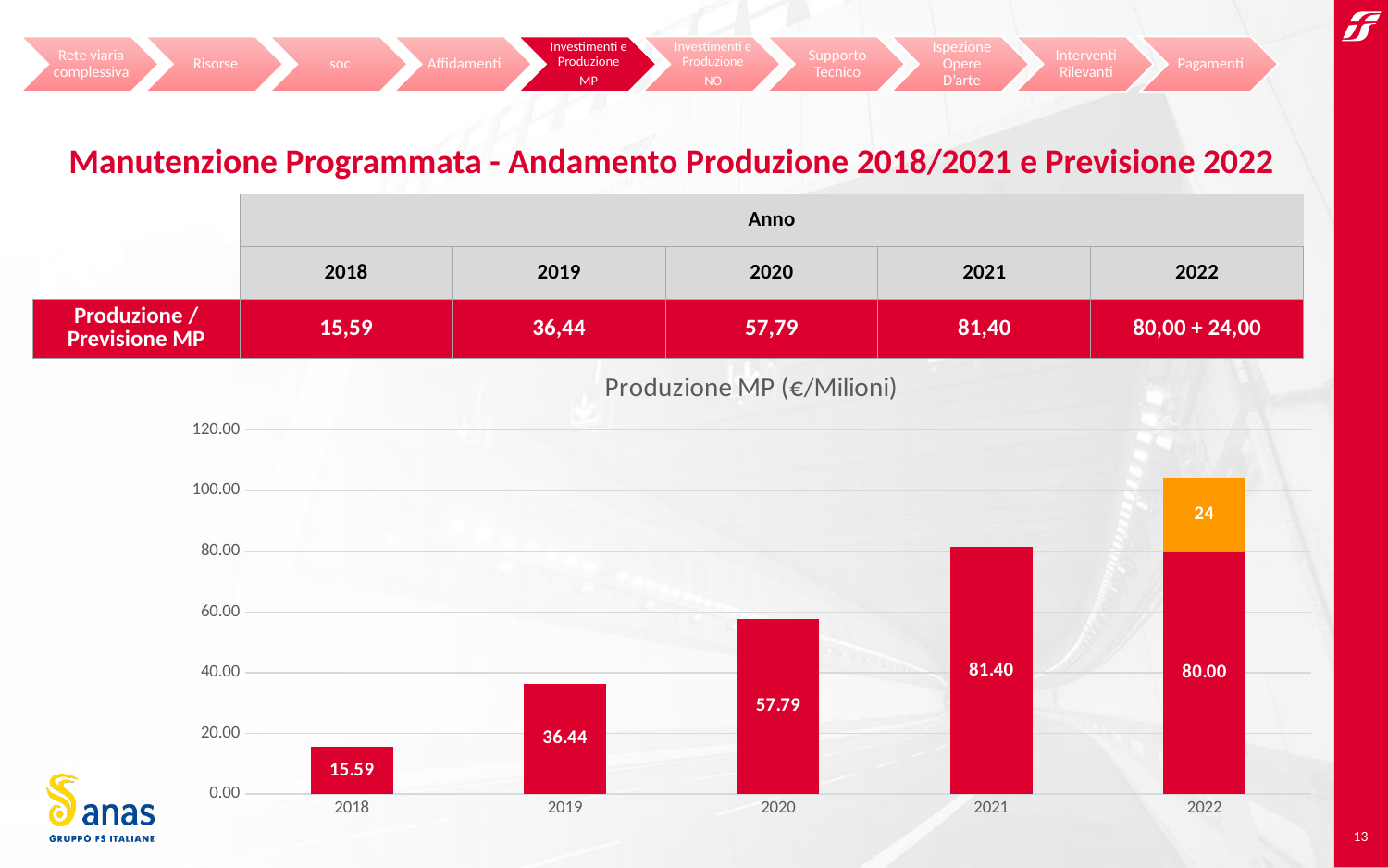
What is the total of the stacked bar for 2022? 104.00 What is the title of the chart? Produzione MP (€/Milioni) Which year has the tallest bar overall? 2022 What is the value of the bar for 2020? 57.79 What is the value of the bar for 2018? 15.59 Which year has the shortest bar? 2018 What is the value of the orange segment on top of the 2022 bar? 24 What kind of chart is shown on the slide? bar chart Is the value for 2019 greater or less than 20.00? greater What is the difference between the values for 2021 and 2020? 23.61 How many years are shown on the x axis? 5 Which is larger, the value for 2019 or the value for 2020? 2020